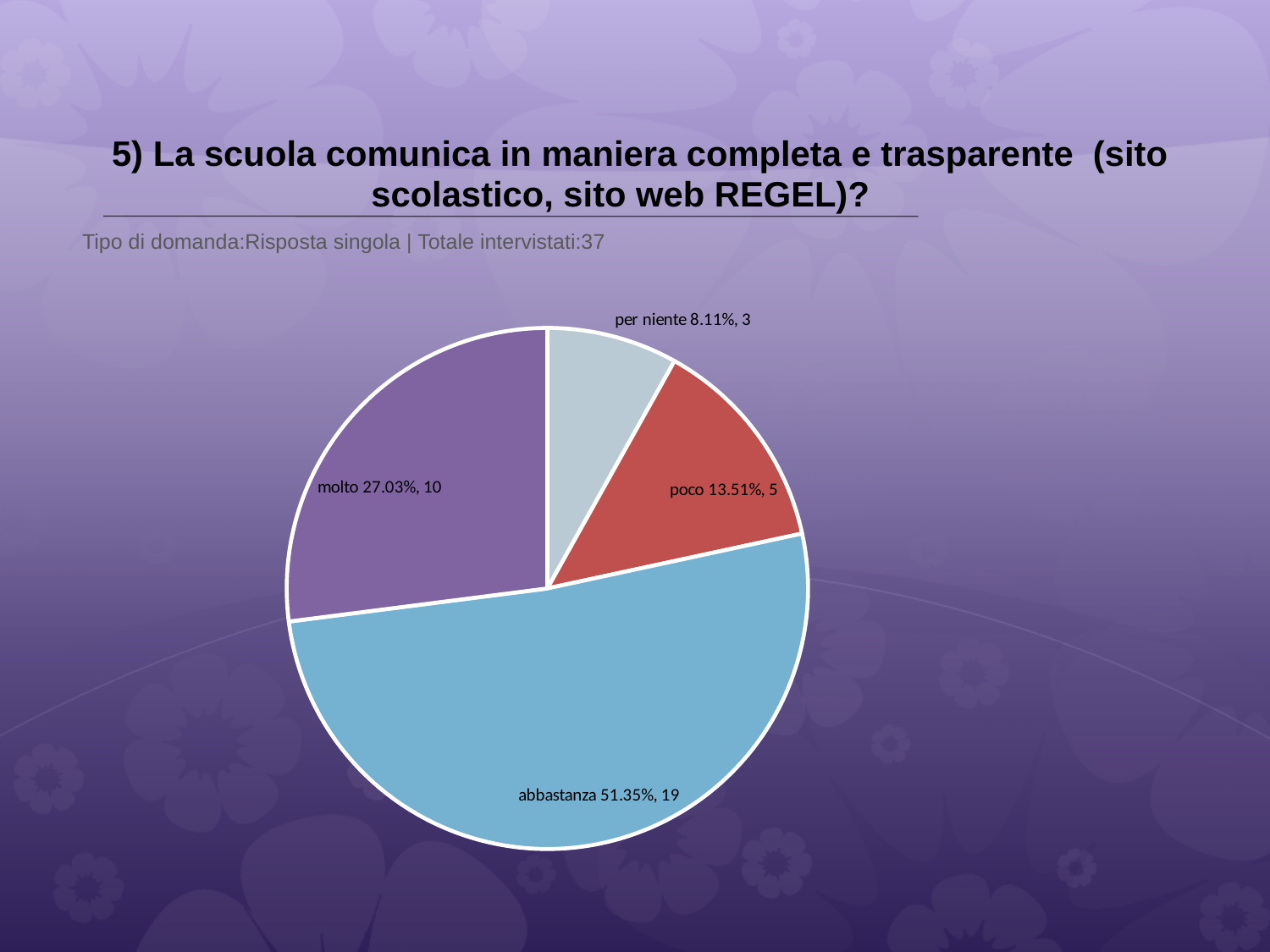
How many respondents answered 'molto'? 10 How many respondents answered 'poco'? 5 What percentage share does the 'per niente' slice have? 8.11% Which category has the largest slice? abbastanza What is the difference in respondent count between 'abbastanza' and 'molto'? 9 What is the total number of respondents across all slices? 37 Which has more respondents, 'poco' or 'per niente'? poco What kind of chart is shown on the slide? pie chart How many slices does the pie chart have? 4 What percentage share does the 'abbastanza' slice have? 51.35% Which category has the smallest slice? per niente What colour is the 'molto' slice? purple